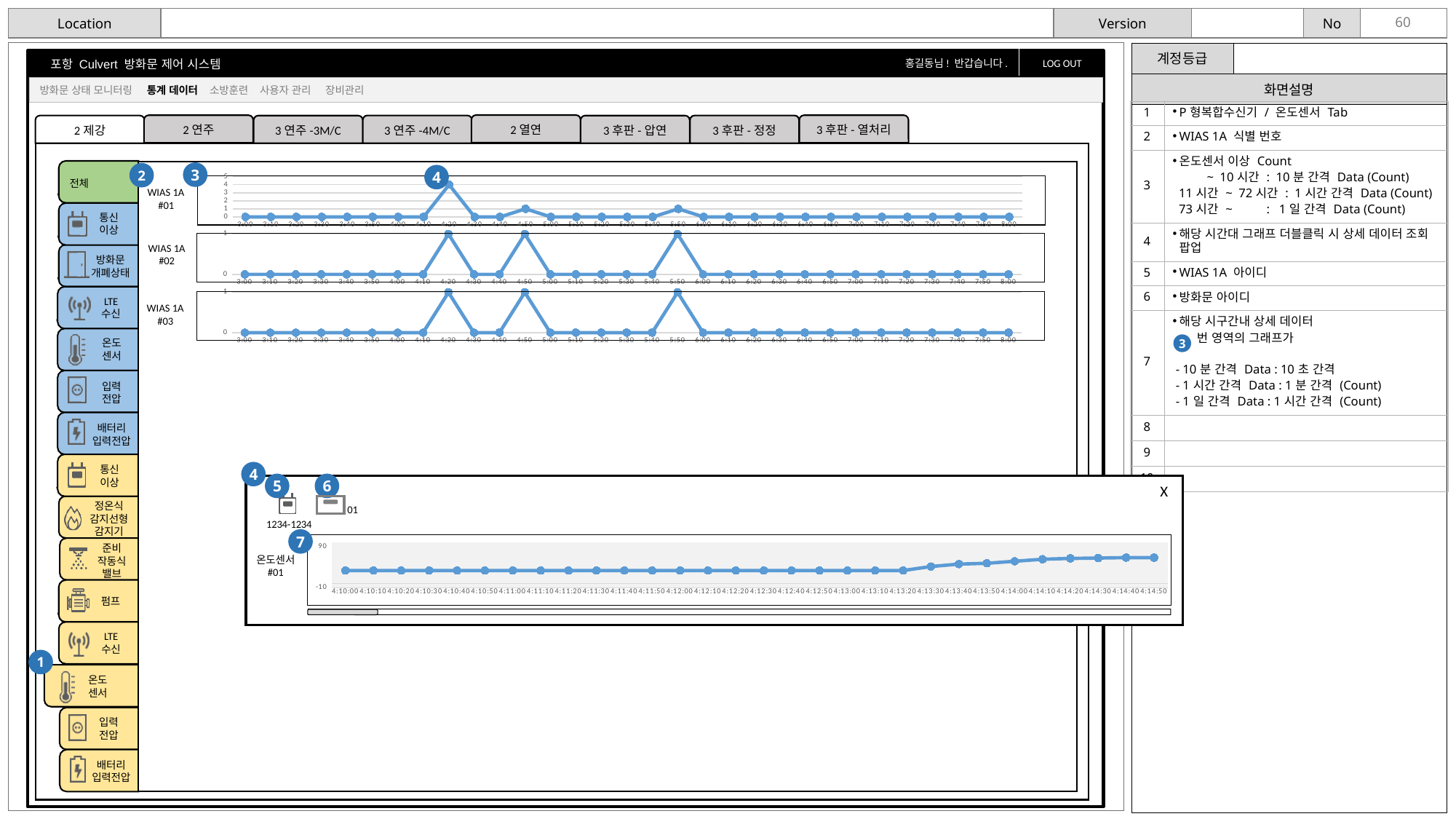
In the 온도센서 #01 popup chart, does the line rise or fall toward the right end of the x axis? rise In the WIAS 1A #02 chart, what is the value at 3:00? 0 In the WIAS 1A #01 chart, is the value at 4:20 greater or less than 3? greater In the WIAS 1A #01 chart, at which time is the value highest? 4:20 In the WIAS 1A #03 chart, what is the value at 5:50? 1 What kind of chart is the WIAS 1A #02 chart? line chart In the WIAS 1A #02 chart, what is the value at 4:20? 1 In the WIAS 1A #01 chart, which is larger, the value at 4:20 or the value at 4:50? 4:20 How many line charts are shown on the slide in total, including the popup? 4 What is the first x-axis label on the 온도센서 #01 popup chart? 4:10:00 In the 온도센서 #01 popup chart, is the value at 4:10:00 greater or less than 90? less In the WIAS 1A #02 chart, how many times does the line reach 1? 3